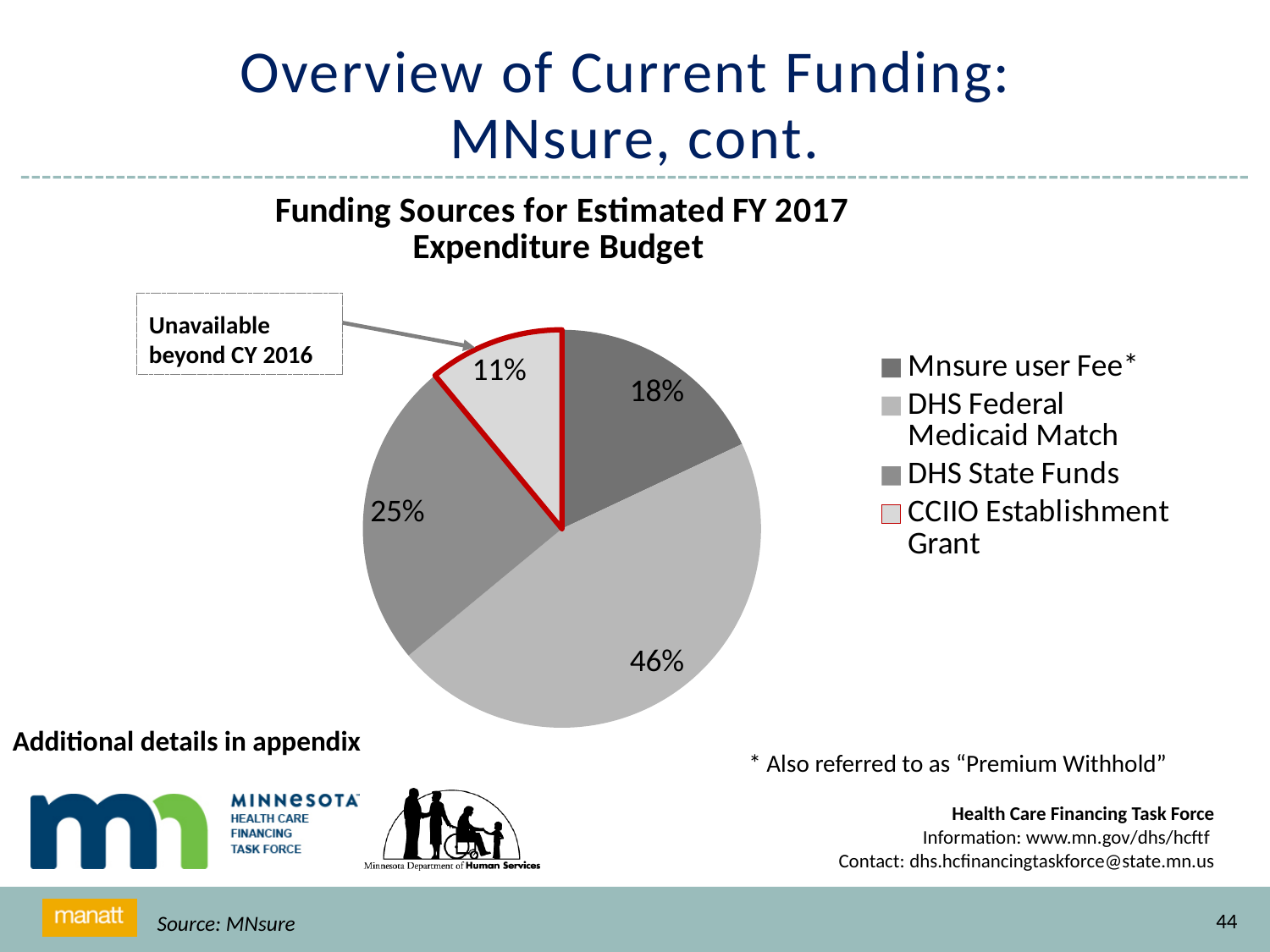
What is the title of the chart? Funding Sources for Estimated FY 2017 Expenditure Budget Which is larger, the Mnsure user Fee share or the DHS State Funds share? DHS State Funds What share of the budget comes from DHS State Funds? 25% Which funding source is labeled as unavailable beyond CY 2016? CCIIO Establishment Grant What share of the FY 2017 expenditure budget comes from the DHS Federal Medicaid Match? 46% What type of chart is shown on the slide? Pie chart What share of the budget comes from the Mnsure user Fee? 18% How many funding sources does the legend list? 4 What share of the budget comes from the CCIIO Establishment Grant? 11% Which funding source is the smallest slice of the pie? CCIIO Establishment Grant Which funding source is the largest slice of the pie? DHS Federal Medicaid Match What is the difference in percentage points between the DHS Federal Medicaid Match and DHS State Funds shares? 21